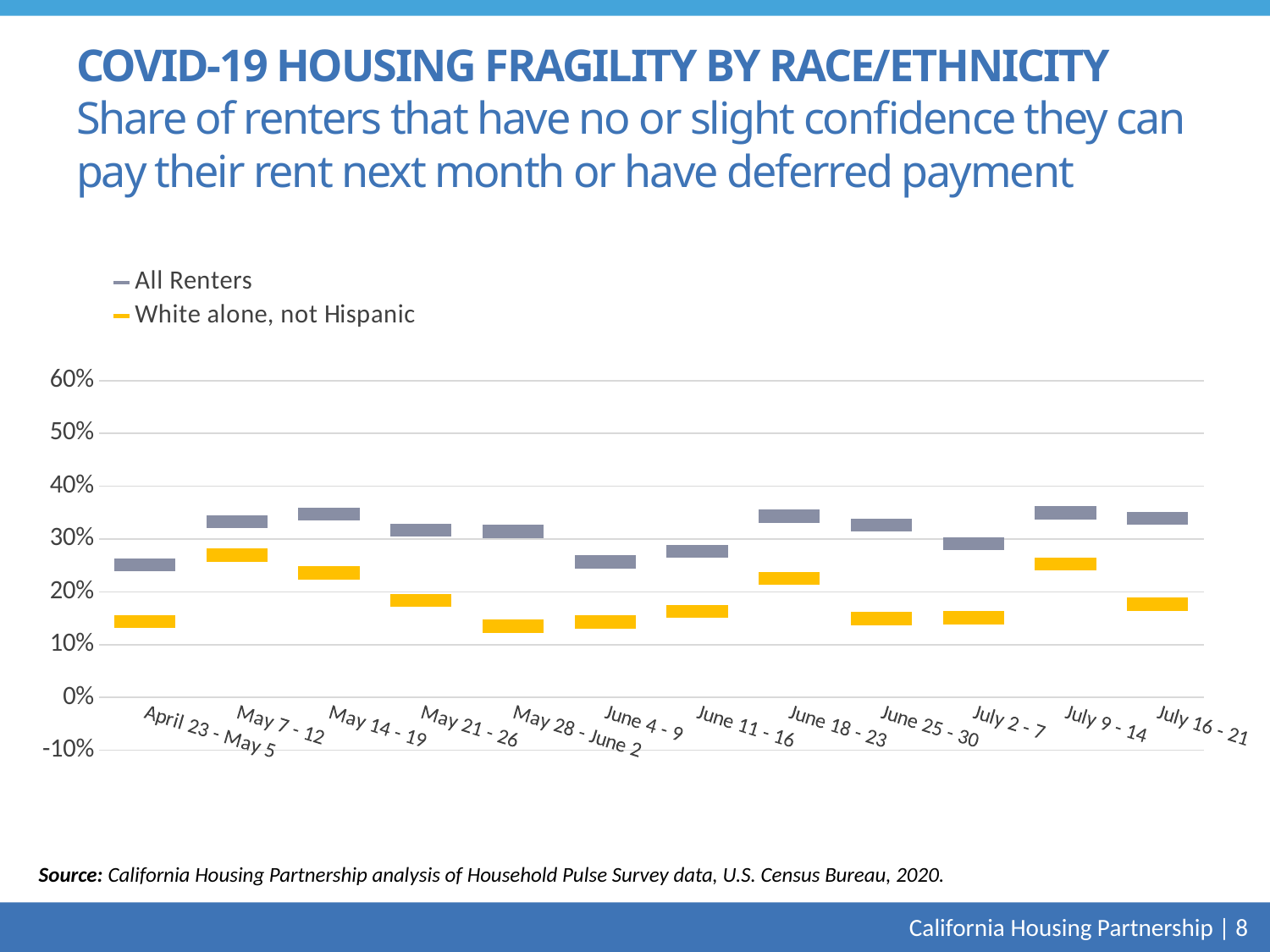
What are the two series named in the legend? All Renters; White alone, not Hispanic Is the White alone, not Hispanic value for May 7 - 12 greater or less than 20%? greater How many survey periods are shown along the x axis? 12 Is the White alone, not Hispanic value for June 18 - 23 greater or less than 20%? greater Is the All Renters value for July 9 - 14 greater or less than 30%? greater Which series is shown in yellow? White alone, not Hispanic For July 16 - 21, which is larger: All Renters or White alone, not Hispanic? All Renters How many series does the legend list? 2 For April 23 - May 5, which is larger: All Renters or White alone, not Hispanic? All Renters